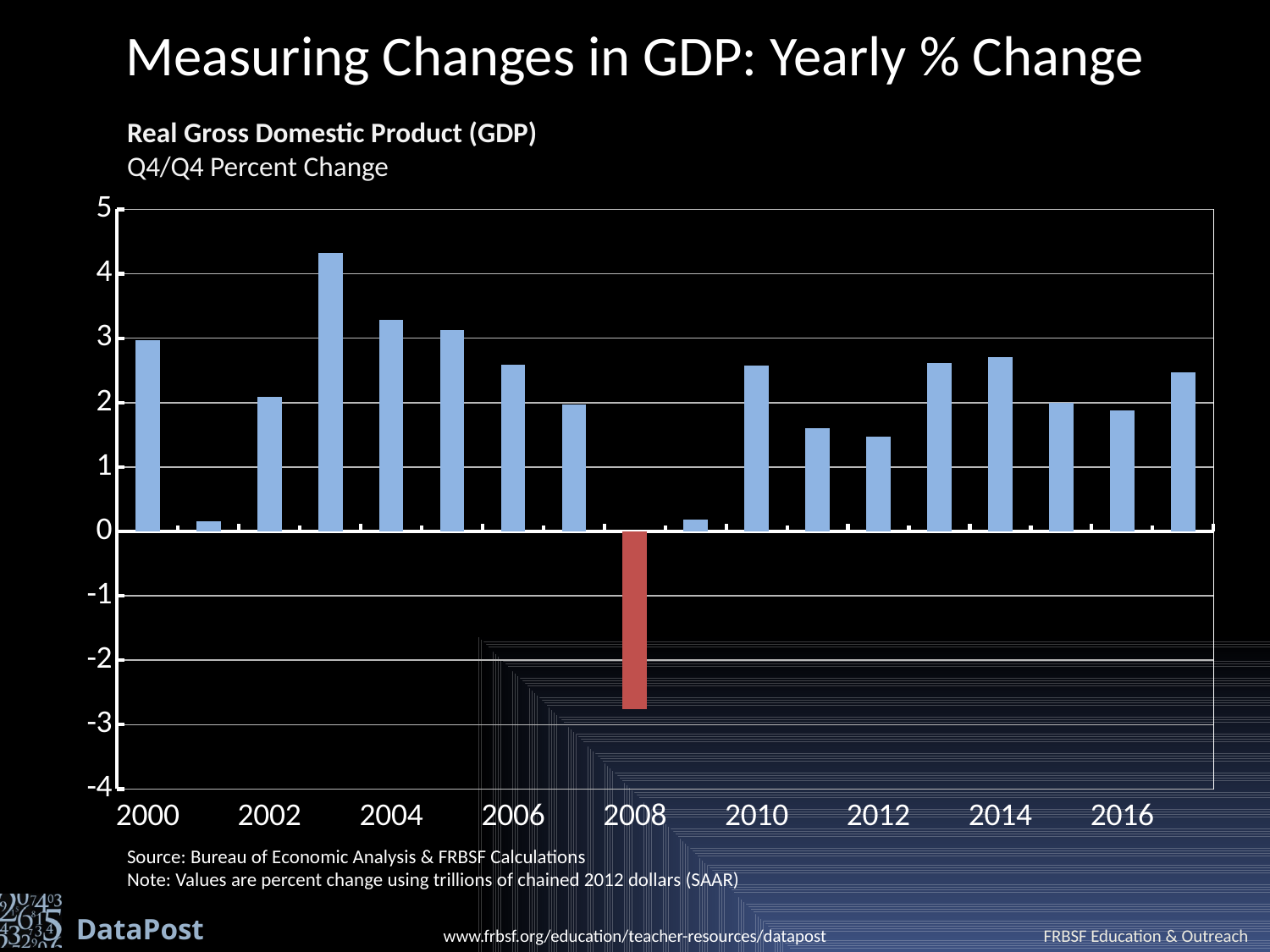
Which year has the lowest Q4/Q4 percent change in real GDP? 2008 What colour is the bar for 2008? Red Which year has the larger value, 2000 or 2002? 2000 What is the source cited for the chart data? Bureau of Economic Analysis & FRBSF Calculations How many years show a negative percent change? 1 Is the value for 2008 greater or less than -2? less Do the values rise or fall from 2003 to 2008? Fall Which year has the highest Q4/Q4 percent change in real GDP? 2003 Is the value for 2004 greater or less than 3? greater Is the value for 2012 greater or less than 2? less What kind of chart is shown on the slide? Bar chart